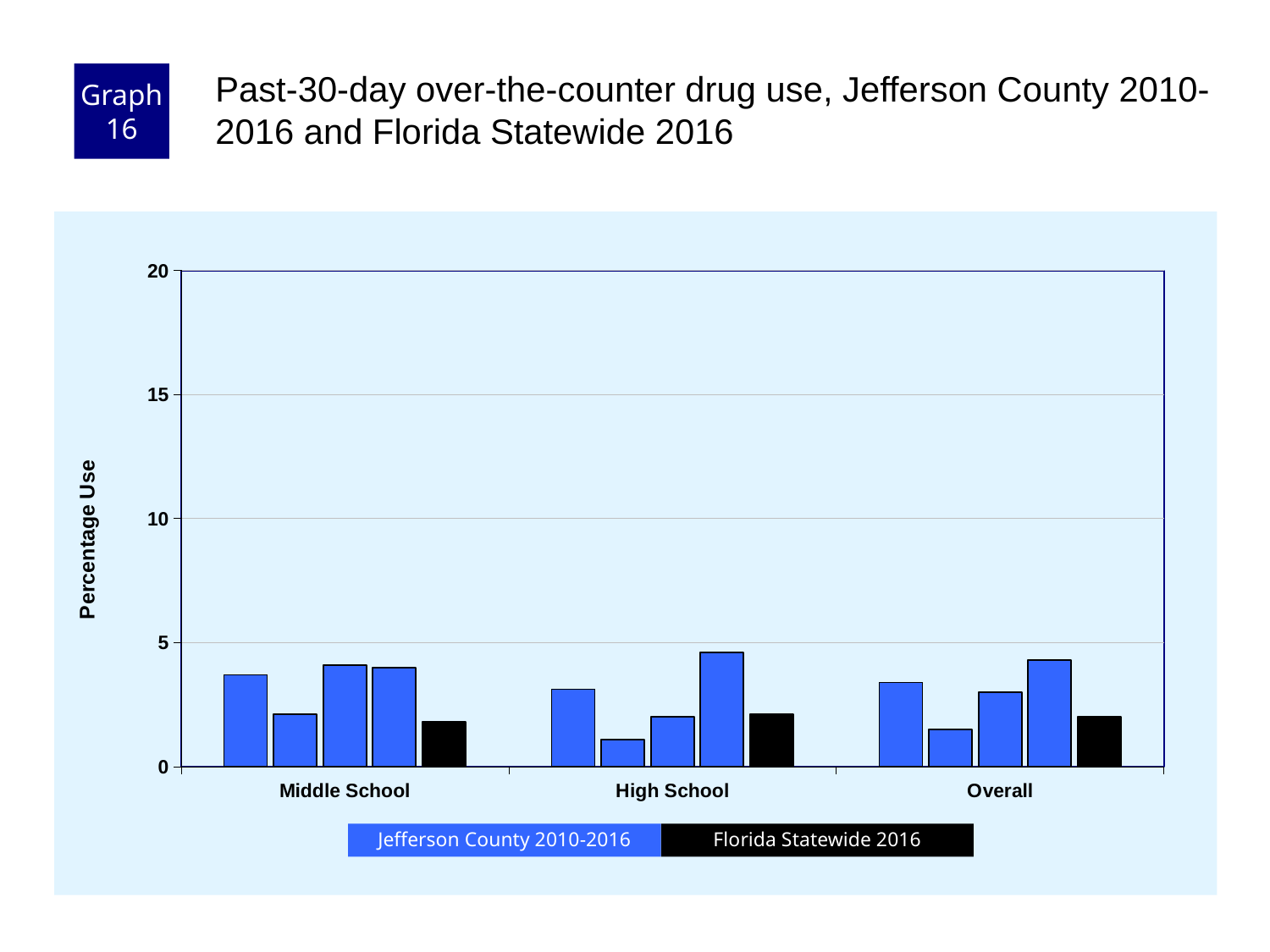
Is the Florida Statewide 2016 value for Middle School greater or less than 5? less What kind of chart is shown on the slide? bar chart Within the High School group, which bar is the tallest? the fourth Jefferson County 2010-2016 bar How many categories are shown on the x axis? 3 What is the highest value shown on the y axis? 20 How many series does the legend list? 2 What are the two series named in the legend? Jefferson County 2010-2016 and Florida Statewide 2016 For High School, which is larger: the tallest Jefferson County 2010-2016 bar or the Florida Statewide 2016 bar? the tallest Jefferson County 2010-2016 bar What is the label of the y axis? Percentage Use Is the Florida Statewide 2016 value for Overall greater or less than 5? less Is the tallest Jefferson County 2010-2016 bar for High School greater or less than 5? less Within the High School group, which bar is the lowest? the second Jefferson County 2010-2016 bar